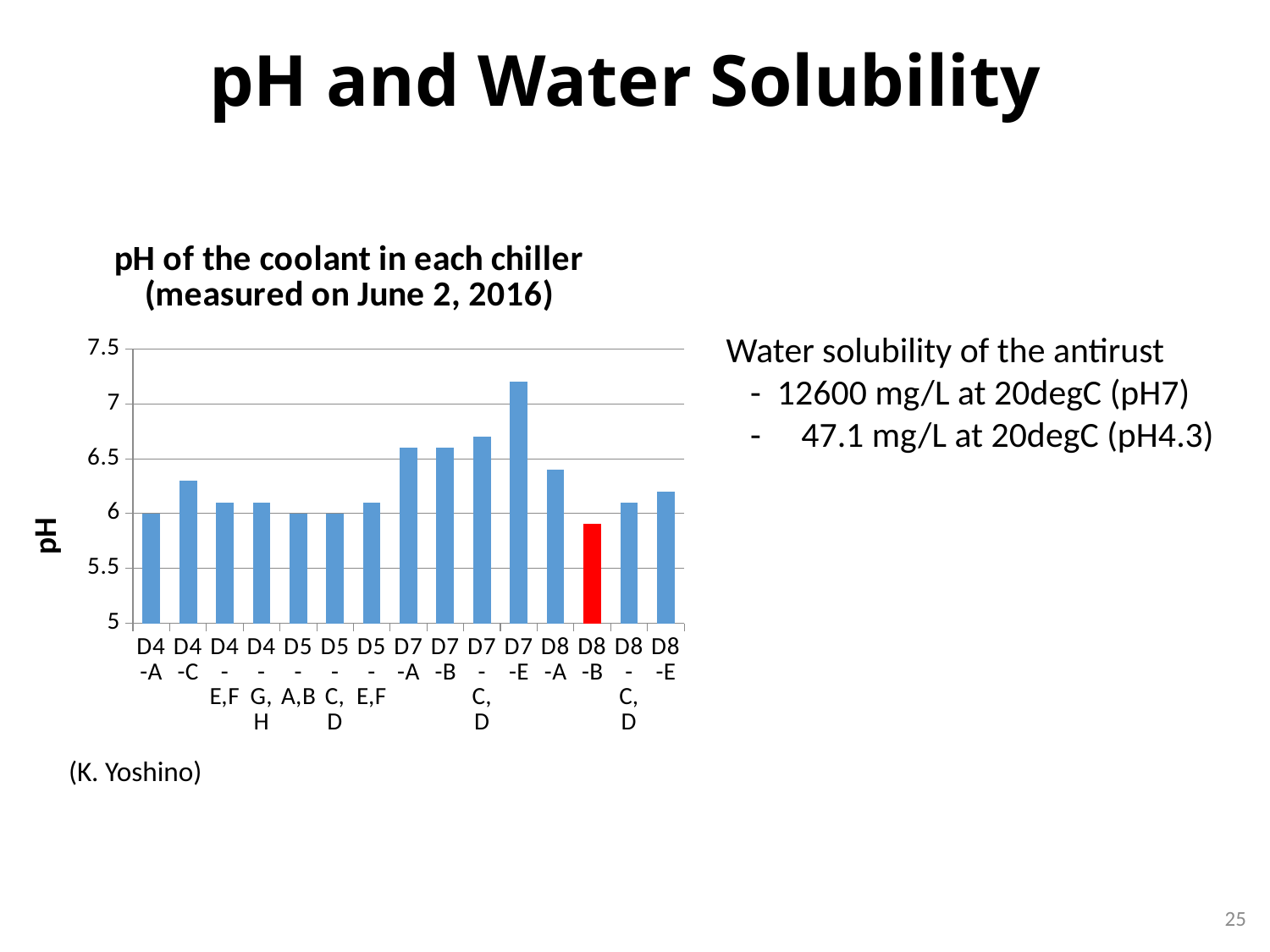
What kind of chart is shown on the slide? bar chart Is the pH value for D8-B greater or less than 6? less Which has a higher pH, D7-E or D8-A? D7-E Is the pH value for D4-C greater or less than 6? greater Is the pH value for D7-A greater or less than 6.5? greater Which chiller has the lowest pH in the chart? D8-B How many chillers (bars) are shown in the chart? 15 Which chiller's bar is coloured red in the chart? D8-B Which has a higher pH, D4-A or D4-C? D4-C Which chiller has the highest pH in the chart? D7-E